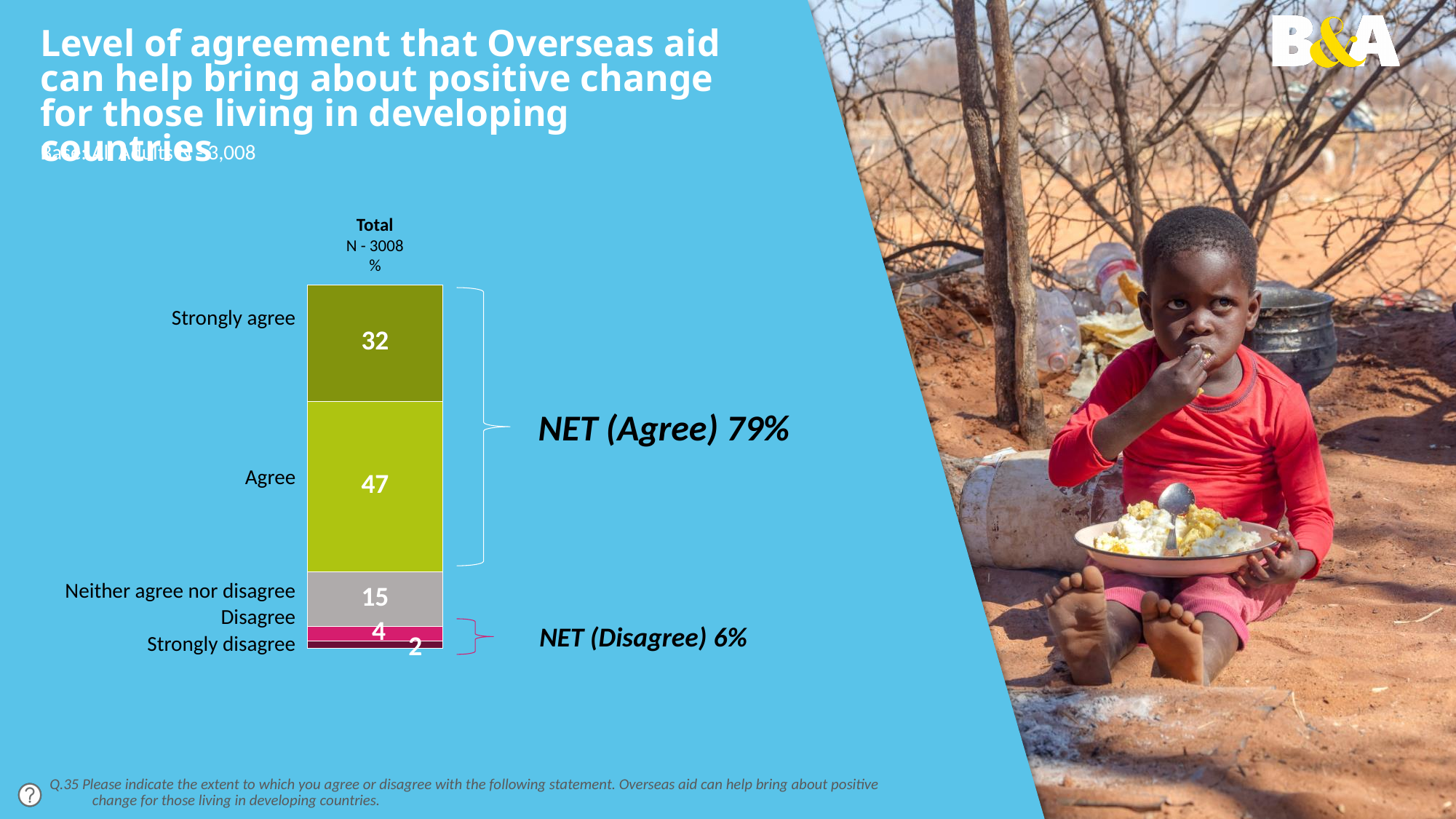
What percentage of respondents strongly agree that overseas aid can help bring about positive change? 32 What percentage of respondents neither agree nor disagree? 15 What percentage of respondents chose 'Agree'? 47 What percentage of respondents strongly disagree? 2 What is the difference in percentage points between 'Agree' and 'Strongly agree'? 15 What percentage of respondents chose 'Disagree'? 4 What is the NET (Disagree) percentage shown on the chart? 6% What kind of chart is shown on the slide? Stacked bar chart Which is larger: the percentage for 'Neither agree nor disagree' or for 'Disagree'? Neither agree nor disagree Which response category has the highest percentage? Agree What is the NET (Agree) percentage shown on the chart? 79% Which response category has the lowest percentage? Strongly disagree